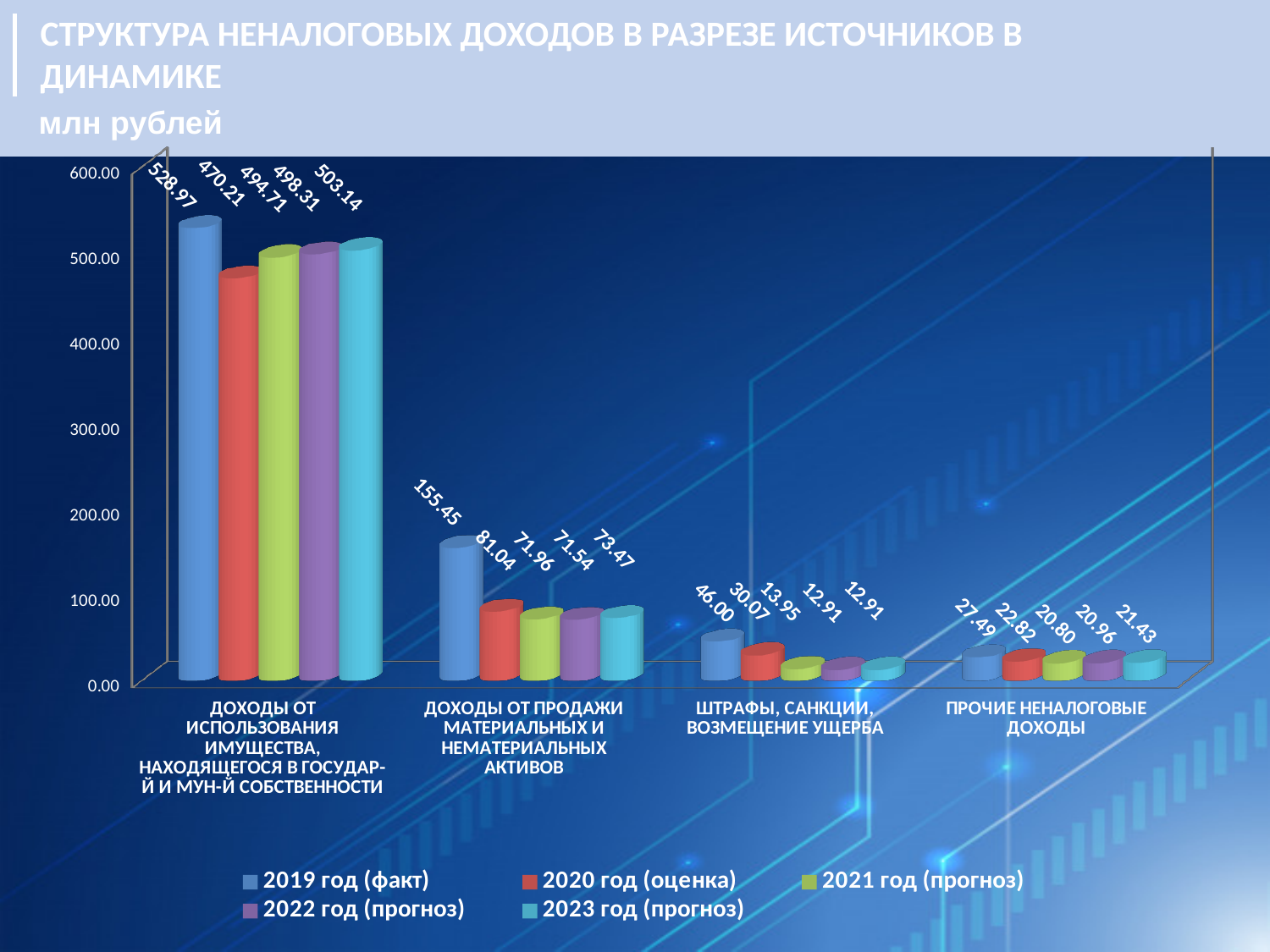
How many categories are shown on the x axis of the chart? 4 What is the difference between the 2019 год (факт) and 2020 год (оценка) values in the category 'Доходы от использования имущества, находящегося в государ-й и мун-й собственности'? 58.76 Which is larger in the category 'Прочие неналоговые доходы': the value for 2022 год (прогноз) or the value for 2023 год (прогноз)? 2023 год (прогноз) What kind of chart is shown on the slide? Bar chart Which series has the lowest value in the category 'Доходы от использования имущества, находящегося в государ-й и мун-й собственности'? 2020 год (оценка) What unit of measurement is stated under the chart title? млн рублей What is the value for 2023 год (прогноз) in the category 'Доходы от продажи материальных и нематериальных активов'? 73.47 Which series has the highest value in the category 'Доходы от продажи материальных и нематериальных активов'? 2019 год (факт) What is the value for 2019 год (факт) in the category 'Доходы от использования имущества, находящегося в государ-й и мун-й собственности'? 528.97 What is the value for 2020 год (оценка) in the category 'Штрафы, санкции, возмещение ущерба'? 30.07 What is the value for 2021 год (прогноз) in the category 'Прочие неналоговые доходы'? 20.80 How many series does the legend list? 5